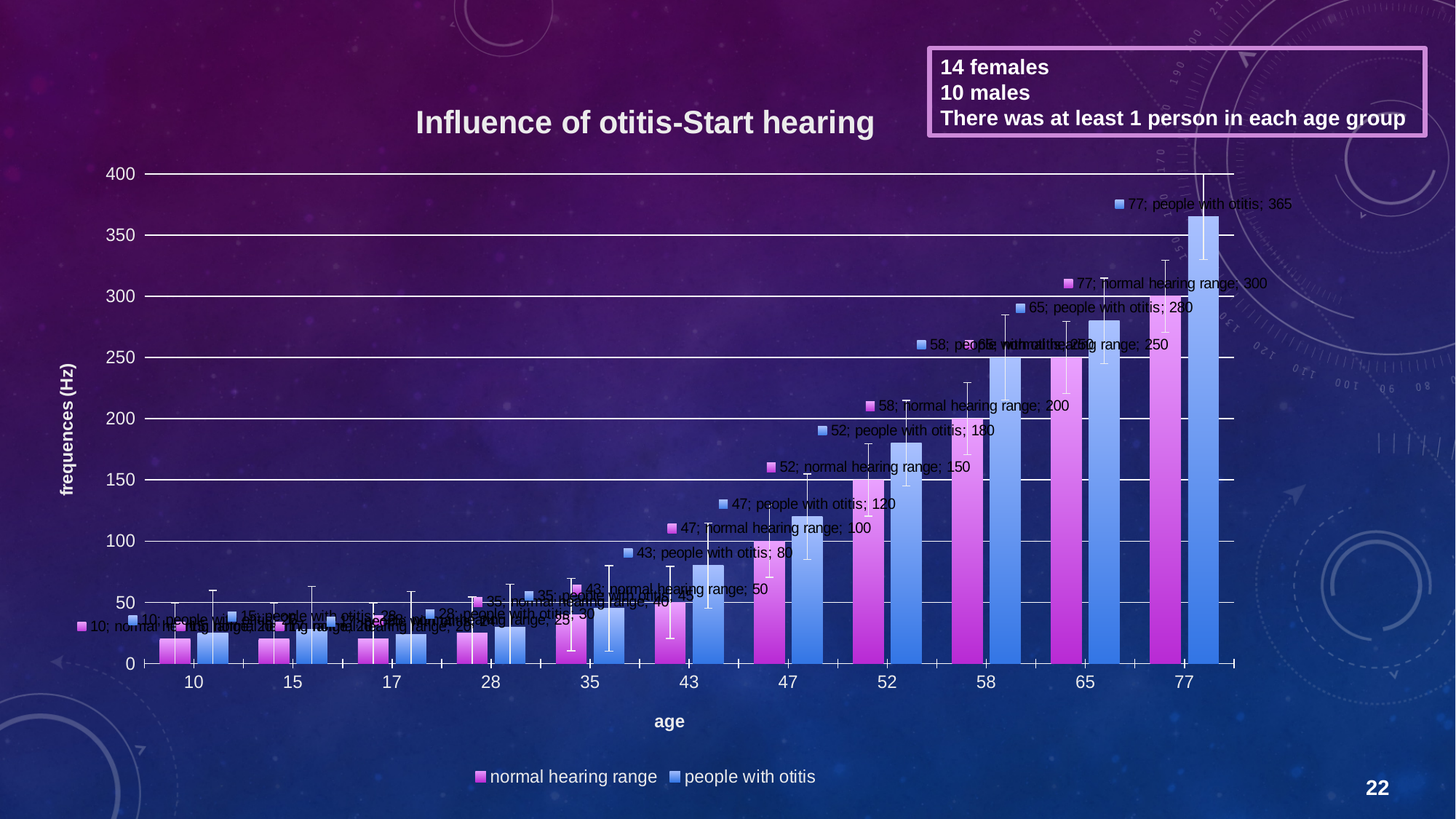
What kind of chart is shown on the slide? bar chart What is the difference between people with otitis and normal hearing range at age 77? 65 What is the value for normal hearing range at age 52? 150 What is the value for normal hearing range at age 77? 300 How many series does the legend list? 2 At age 47, which series has the larger value: normal hearing range or people with otitis? people with otitis What is the value for people with otitis at age 77? 365 How many age groups are shown on the x axis? 11 Do the values for people with otitis rise or fall as age increases along the x axis? rise What is the value for people with otitis at age 65? 280 Which age group has the highest value for people with otitis? 77 Is the value for normal hearing range at age 10 greater or less than 50? less